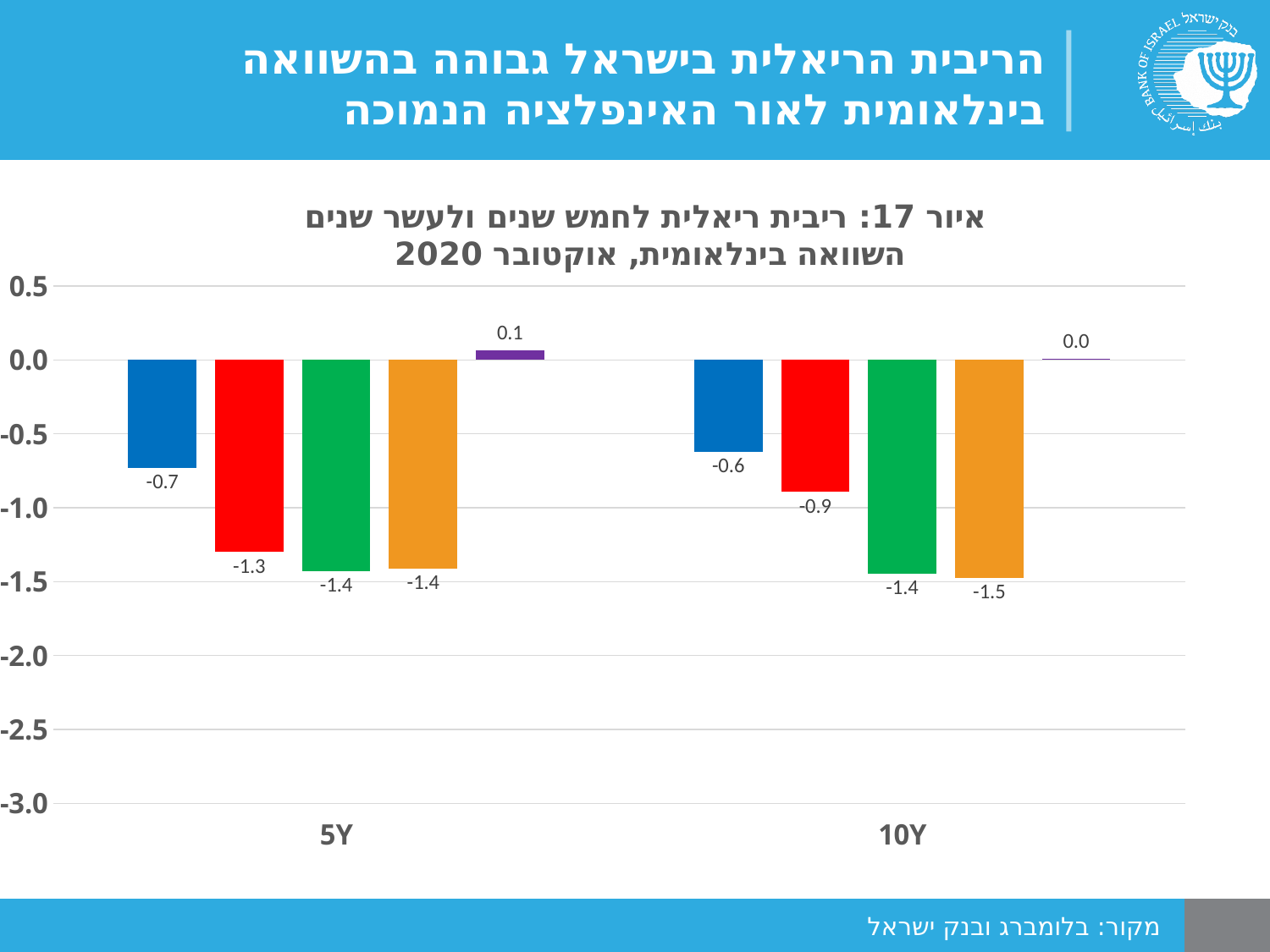
What is the value of the green bar for 10Y? -1.4 What kind of chart is shown on the slide? bar chart Which coloured bar has the highest value in the 5Y group? purple What is the value of the orange bar for 10Y? -1.5 What is the value of the purple bar for 5Y? 0.1 How many categories are shown on the x axis? 2 What is the value of the red bar for 10Y? -0.9 What figure number is given in the chart title? 17 What is the value of the blue bar for 5Y? -0.7 What is the difference between the red bar for 5Y and the red bar for 10Y? 0.4 Which is larger, the blue bar for 5Y or the blue bar for 10Y? 10Y Which coloured bar has the lowest value in the 10Y group? orange